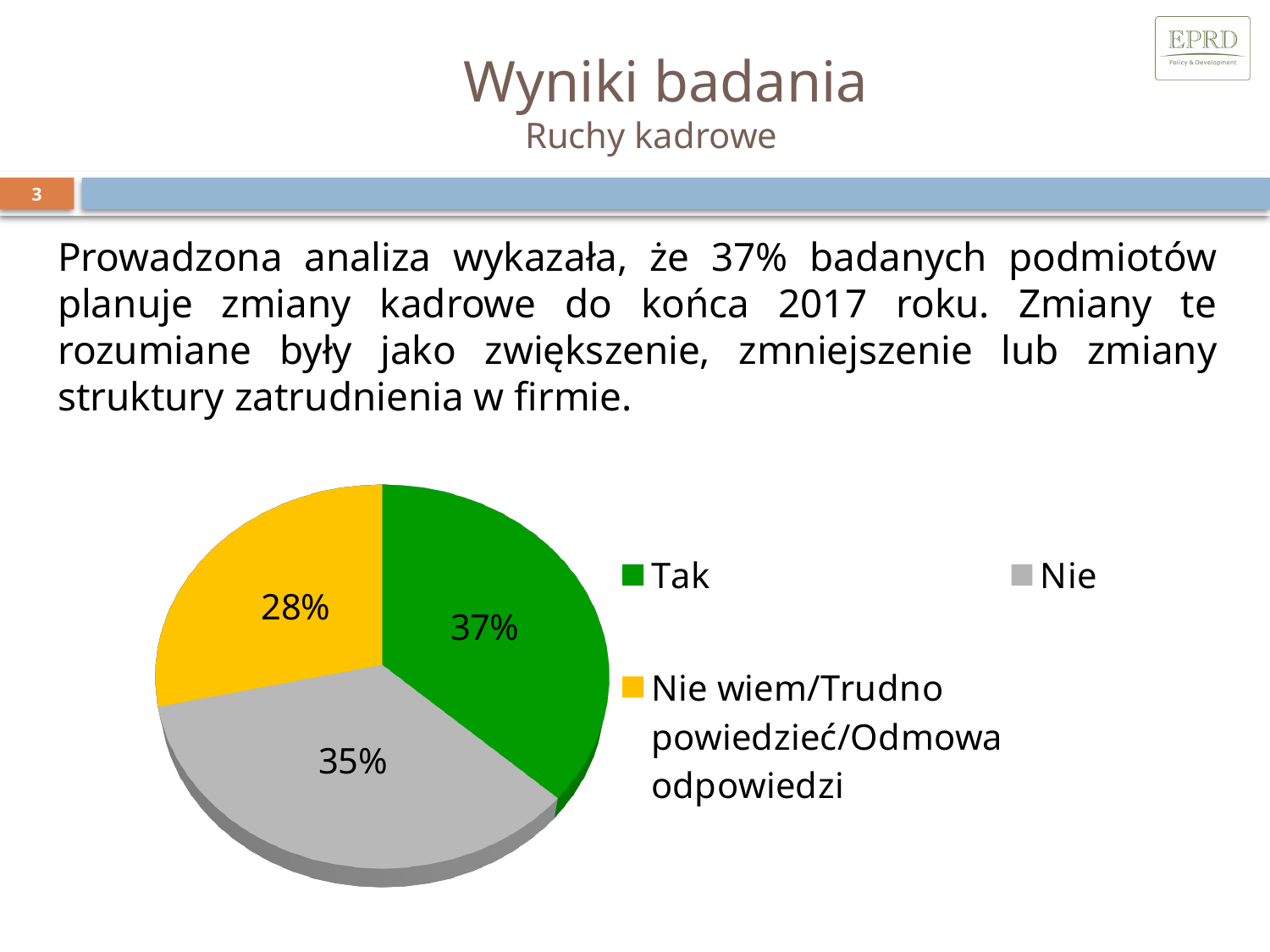
What colour is the "Tak" slice in the pie chart? green What kind of chart is shown on the slide? pie chart What percentage of the pie is the "Nie wiem/Trudno powiedzieć/Odmowa odpowiedzi" slice? 28% How many entries does the legend list? 3 What percentage of the pie is the "Nie" slice? 35% Which slice of the pie is the largest? Tak Which is larger, the "Nie" slice or the "Nie wiem/Trudno powiedzieć/Odmowa odpowiedzi" slice? Nie What is the difference in percentage points between the "Tak" and "Nie wiem/Trudno powiedzieć/Odmowa odpowiedzi" slices? 9 Which slice of the pie is the smallest? Nie wiem/Trudno powiedzieć/Odmowa odpowiedzi What percentage of the pie is the "Tak" slice? 37% What is the difference in percentage points between the "Nie" and "Nie wiem/Trudno powiedzieć/Odmowa odpowiedzi" slices? 7 How many slices does the pie chart have? 3